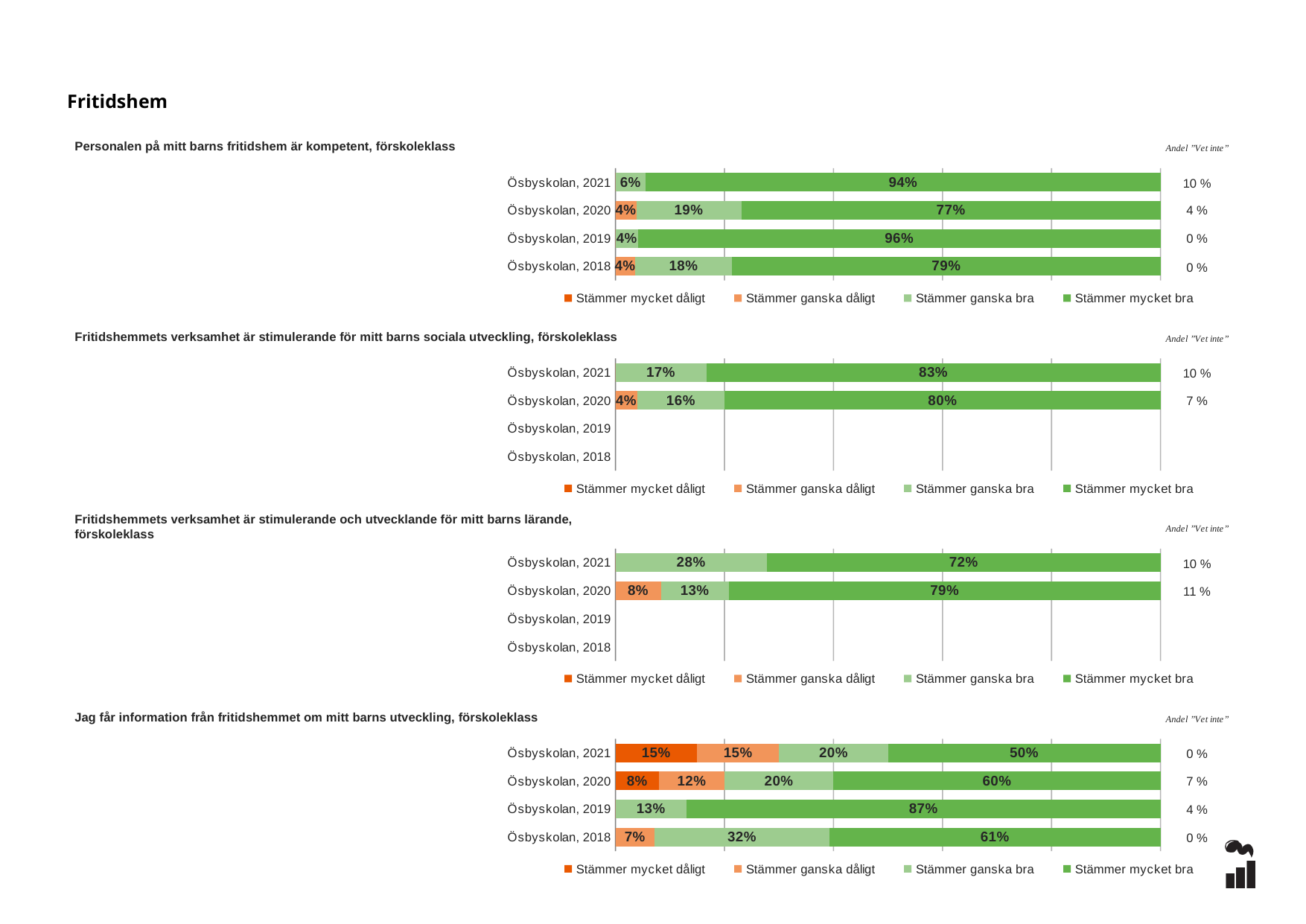
In the chart 'Jag får information från fritidshemmet om mitt barns utveckling, förskoleklass', which year has the lowest 'Stämmer mycket bra' value? Ösbyskolan, 2021 In the chart 'Fritidshemmets verksamhet är stimulerande och utvecklande för mitt barns lärande, förskoleklass', what is the 'Stämmer ganska dåligt' value for Ösbyskolan, 2020? 8% In the chart 'Personalen på mitt barns fritidshem är kompetent, förskoleklass', what is the 'Stämmer mycket bra' value for Ösbyskolan, 2021? 94% In the chart 'Fritidshemmets verksamhet är stimulerande för mitt barns sociala utveckling, förskoleklass', what is the 'Stämmer ganska bra' value for Ösbyskolan, 2021? 17% In the chart 'Personalen på mitt barns fritidshem är kompetent, förskoleklass', which year has the highest 'Stämmer mycket bra' value? Ösbyskolan, 2019 In the chart 'Jag får information från fritidshemmet om mitt barns utveckling, förskoleklass', what is the total of the labelled segments for Ösbyskolan, 2018? 100% In the chart 'Fritidshemmets verksamhet är stimulerande och utvecklande för mitt barns lärande, förskoleklass', which year has the larger 'Stämmer mycket bra' value, Ösbyskolan, 2021 or Ösbyskolan, 2020? Ösbyskolan, 2020 What kind of chart is 'Personalen på mitt barns fritidshem är kompetent, förskoleklass'? Stacked bar chart In the chart 'Jag får information från fritidshemmet om mitt barns utveckling, förskoleklass', what is the 'Stämmer mycket dåligt' value for Ösbyskolan, 2021? 15% In the chart 'Fritidshemmets verksamhet är stimulerande för mitt barns sociala utveckling, förskoleklass', what is the 'Andel Vet inte' value for Ösbyskolan, 2020? 7 % How many series does the legend list in the chart 'Jag får information från fritidshemmet om mitt barns utveckling, förskoleklass'? 4 In the chart 'Personalen på mitt barns fritidshem är kompetent, förskoleklass', what is the difference between the 'Stämmer mycket bra' values for Ösbyskolan, 2019 and Ösbyskolan, 2020? 19 percentage points